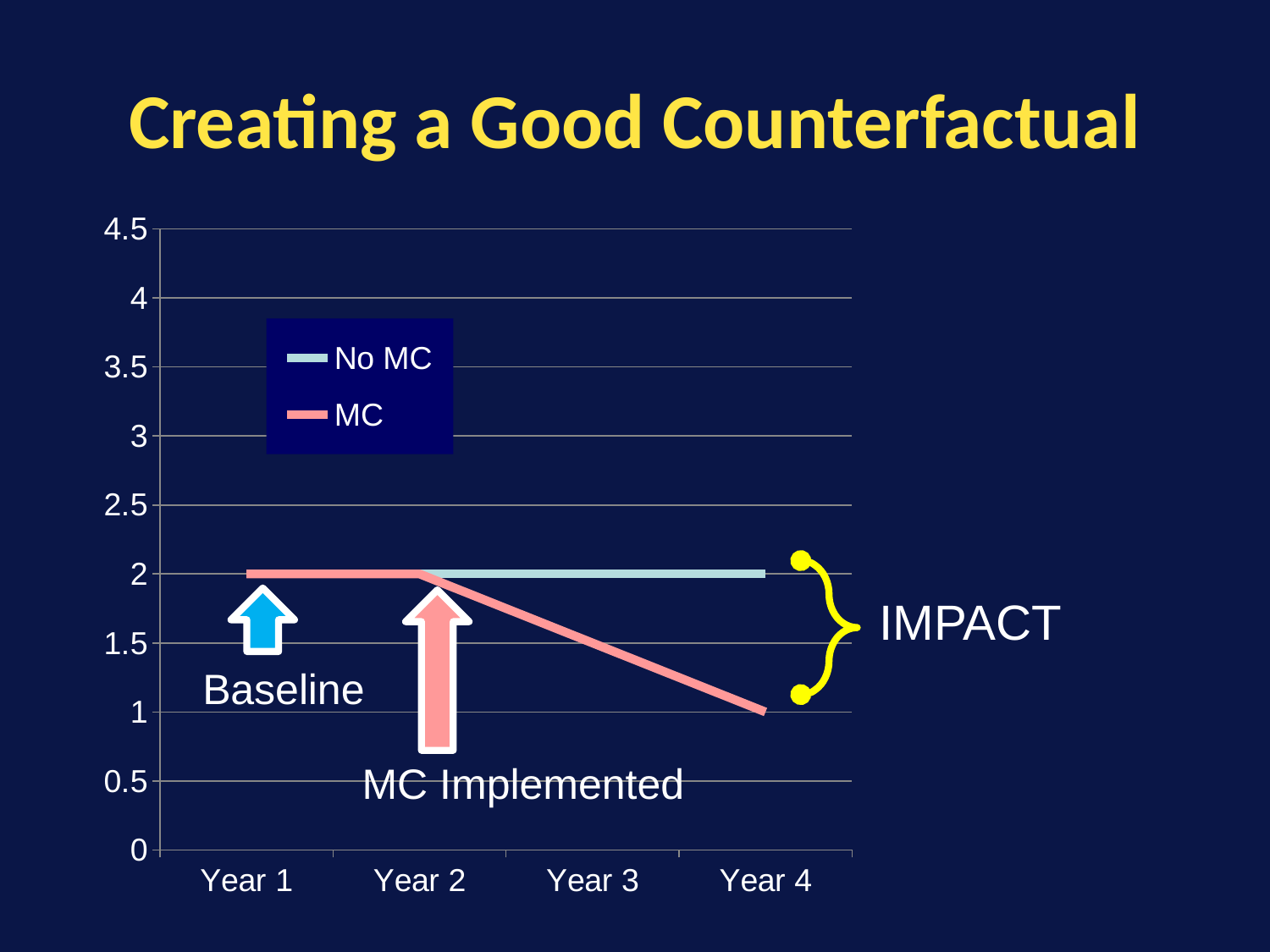
How many series does the legend list? 2 What is the value of the No MC series in Year 4? 2 Does the MC series rise or fall from Year 2 to Year 4? fall What is the value of the MC series in Year 1? 2 In Year 4, which series has the higher value, No MC or MC? No MC Does the No MC series rise, fall, or stay flat from Year 2 to Year 4? stay flat What kind of chart is shown on the slide? line chart In which year is the MC series at its lowest value? Year 4 How many years are shown on the x axis? 4 In Year 4, what is the difference between the No MC value and the MC value? 1 Is the value of the MC series in Year 3 greater or less than 2? less What is the value of the MC series in Year 4? 1